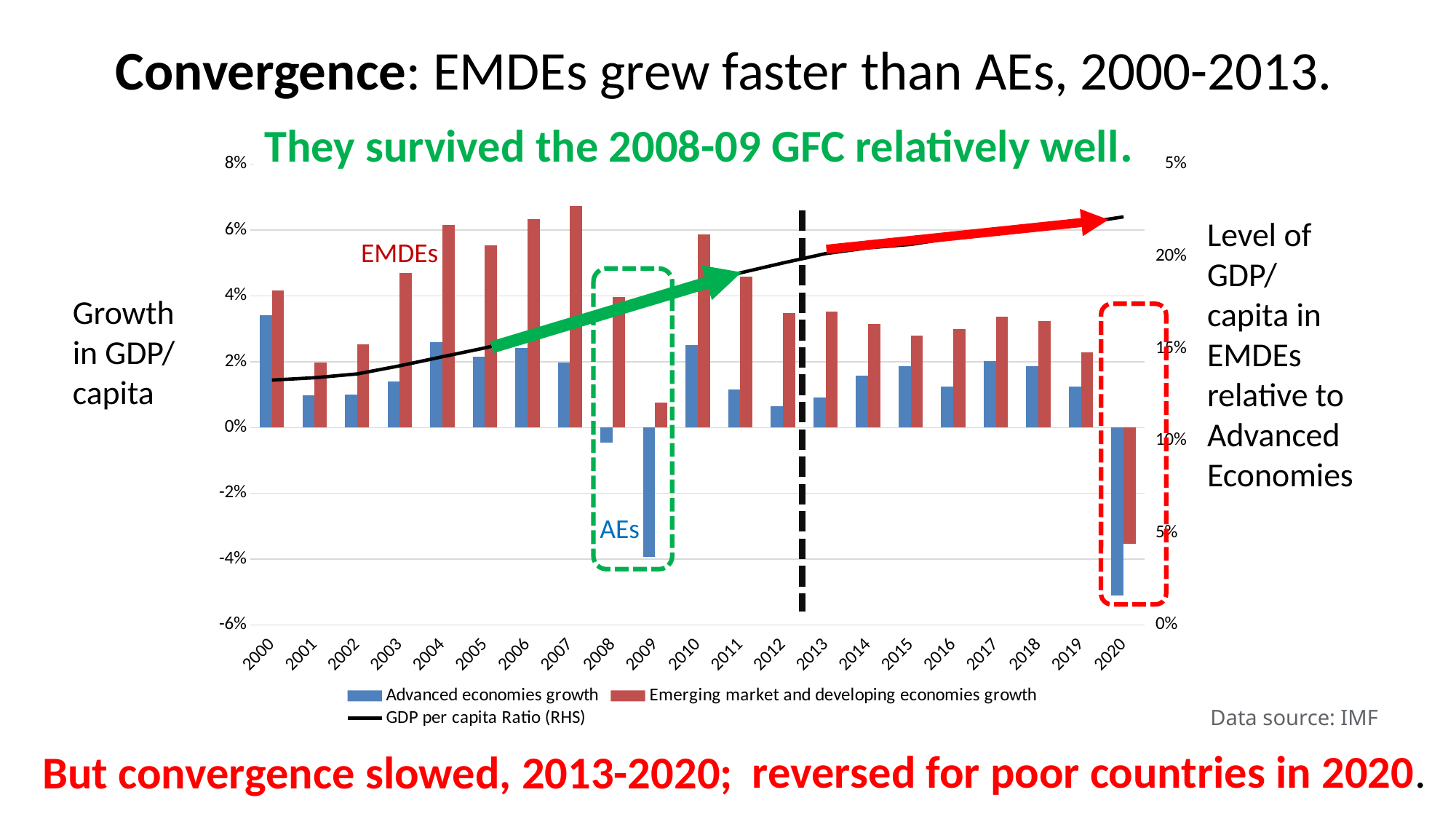
In 2020, which is larger: Advanced economies growth or Emerging market and developing economies growth? Emerging market and developing economies growth How many years are shown on the x axis? 21 What kind of chart is shown on the slide? bar chart with a line What colour are the Advanced economies growth bars? blue In 2009, which is larger: Advanced economies growth or Emerging market and developing economies growth? Emerging market and developing economies growth Is the value for Advanced economies growth in 2009 greater or less than -2%? less Does the GDP per capita Ratio (RHS) line rise or fall from 2000 to 2020? rise In which year is Advanced economies growth lowest? 2020 In which year is Advanced economies growth highest? 2000 How many series does the legend list? 3 Is the value for Emerging market and developing economies growth in 2007 greater or less than 6%? greater In which year is Emerging market and developing economies growth highest? 2007